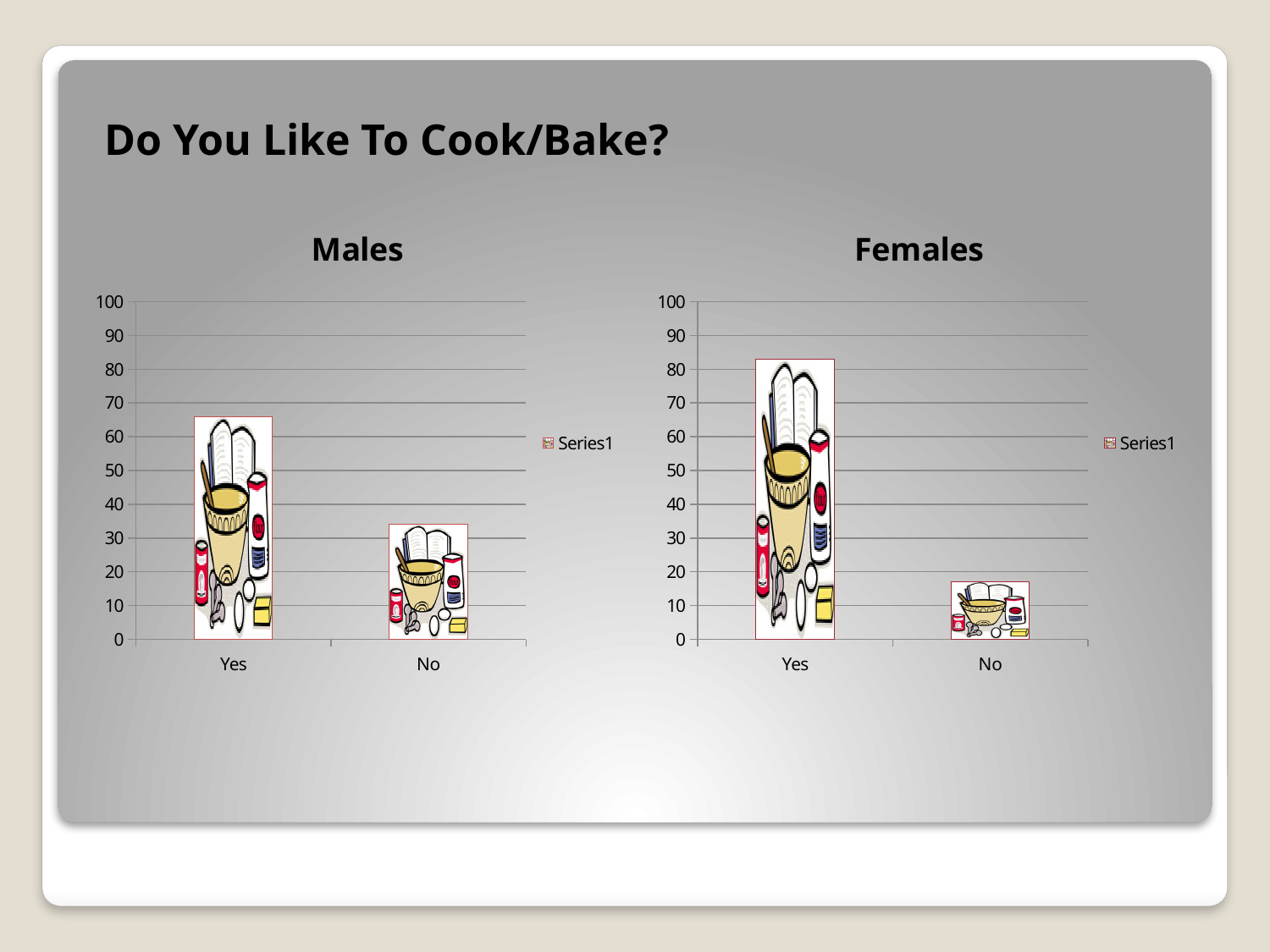
In the Males chart, is the value for No greater or less than 40? less In the Females chart, which category has the lowest value? No How many series does the legend of the Males chart list? 1 What is the title of the slide above the two charts? Do You Like To Cook/Bake? What is the legend entry shown next to the Females chart? Series1 Which is larger: the Yes value in the Males chart or the Yes value in the Females chart? Females In the Females chart, is the value for No greater or less than 30? less What kind of chart is the Males chart? bar chart In the Males chart, is the value for Yes greater or less than 60? greater How many categories are shown on the x axis of the Females chart? 2 In the Males chart, which category has the highest value? Yes